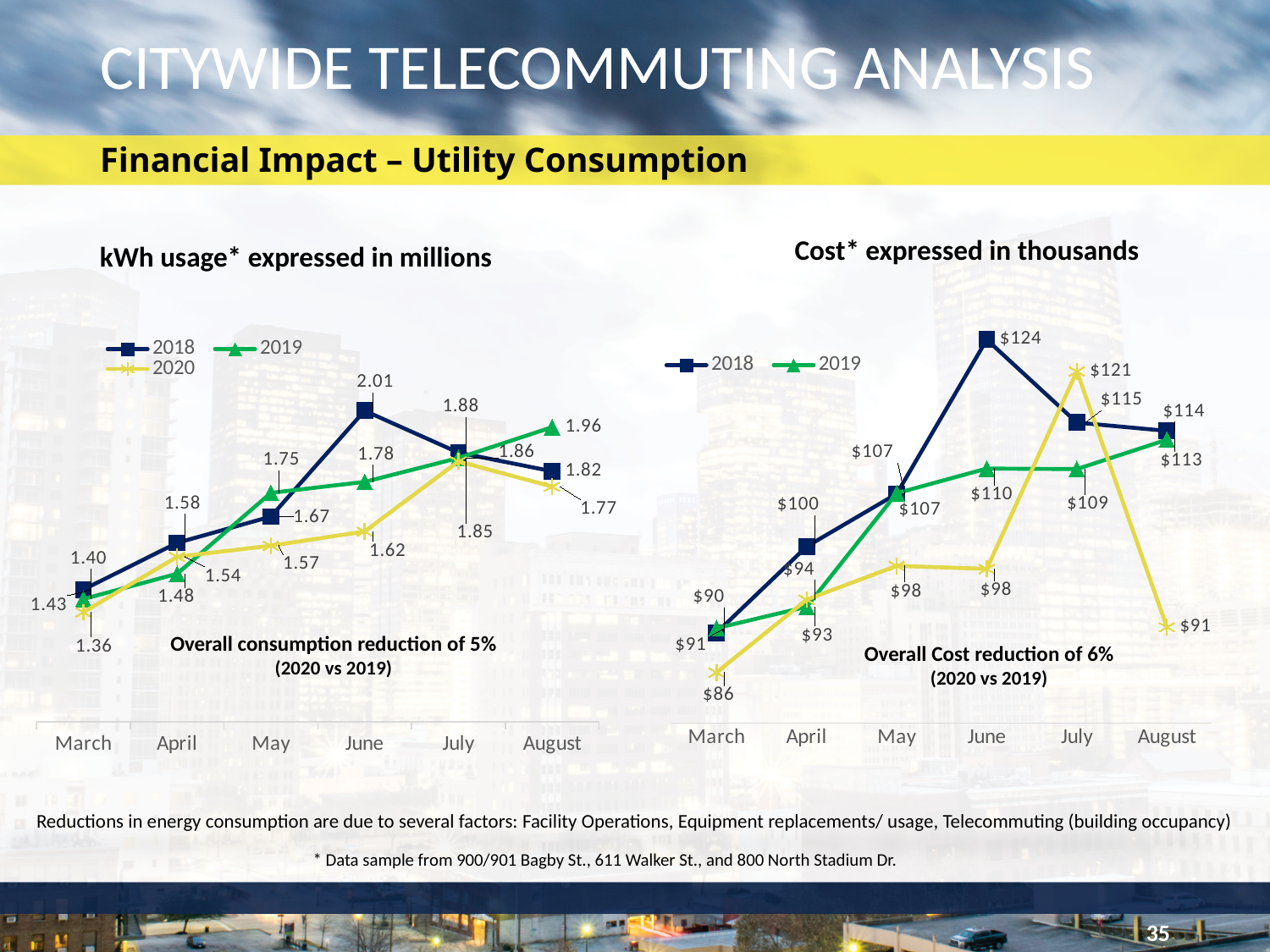
How many series does the legend of the 'kWh usage* expressed in millions' chart list? 3 In the 'Cost* expressed in thousands' chart, what is the 2018 value for June? $124 In the 'kWh usage* expressed in millions' chart, what is the 2018 value for June? 2.01 In the 'kWh usage* expressed in millions' chart, what is the 2020 value for March? 1.36 In the 'kWh usage* expressed in millions' chart, what is the difference between the 2018 and 2019 values for June? 0.23 What kind of chart is the 'kWh usage* expressed in millions' chart? line chart In the 'Cost* expressed in thousands' chart, what is the 2020 value for July? $121 In the 'Cost* expressed in thousands' chart, which is larger for June, the 2018 value or the 2019 value? 2018 In the 'kWh usage* expressed in millions' chart, what is the 2019 value for August? 1.96 In the 'kWh usage* expressed in millions' chart, which month has the highest 2018 value? June How many months are shown on the x axis of the 'kWh usage* expressed in millions' chart? 6 In the 'Cost* expressed in thousands' chart, what is the difference between the 2018 and 2019 values for June? $14